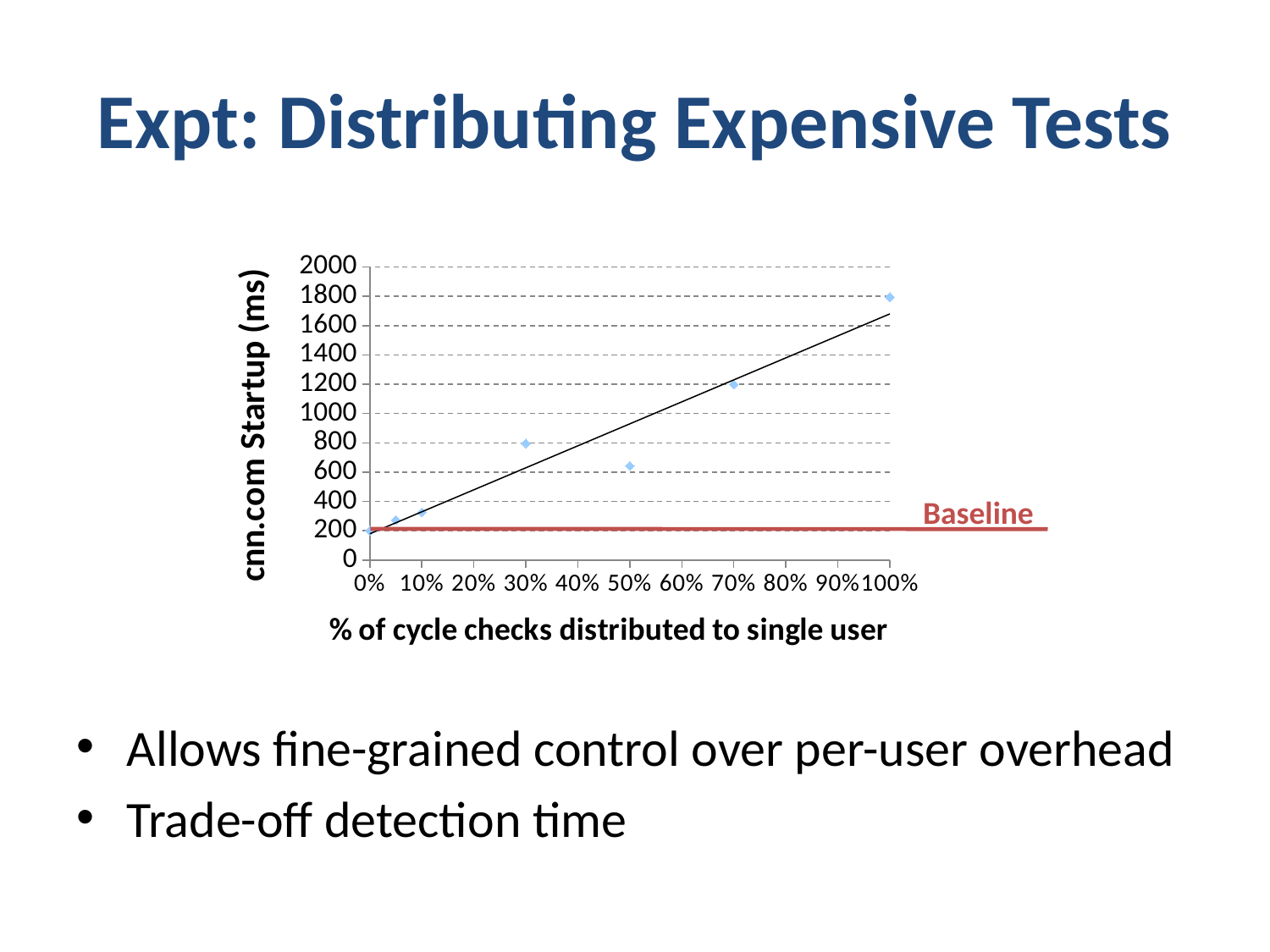
What kind of chart is shown on the slide? scatter chart Is the cnn.com startup value at 30% greater or less than 600? greater What is the title of the y axis? cnn.com Startup (ms) Is the cnn.com startup value at 100% greater or less than 1600? greater At which percentage of cycle checks distributed is the cnn.com startup time lowest? 0% Is the cnn.com startup value at 50% greater or less than 800? less Which has the higher cnn.com startup time, 30% or 50% of cycle checks distributed? 30% What is the title of the x axis? % of cycle checks distributed to single user At which percentage of cycle checks distributed is the cnn.com startup time highest? 100% Does the cnn.com startup time generally rise or fall as the percentage of cycle checks distributed increases? rise